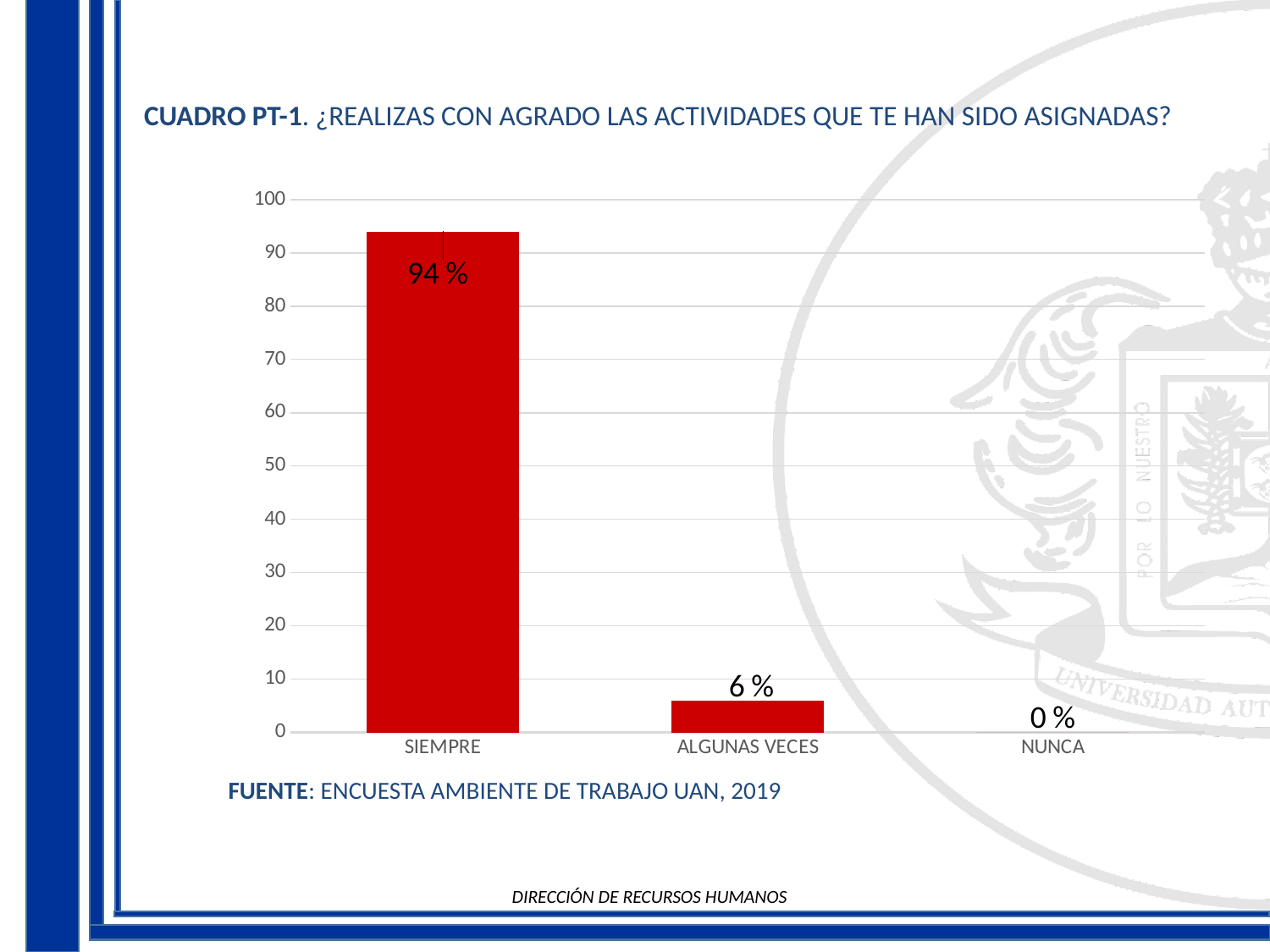
Which is larger, the value for ALGUNAS VECES or the value for NUNCA? ALGUNAS VECES What is the value for ALGUNAS VECES? 6 % What kind of chart is shown on the slide? bar chart Which category has the highest value? SIEMPRE How many categories are shown on the x axis? 3 What is the source cited below the chart? ENCUESTA AMBIENTE DE TRABAJO UAN, 2019 What is the difference between the values for SIEMPRE and ALGUNAS VECES? 88 % What is the value for NUNCA? 0 % What is the value for SIEMPRE? 94 % Which category has the lowest value? NUNCA Is the value for SIEMPRE greater or less than 90? greater Is the value for ALGUNAS VECES greater or less than 10? less